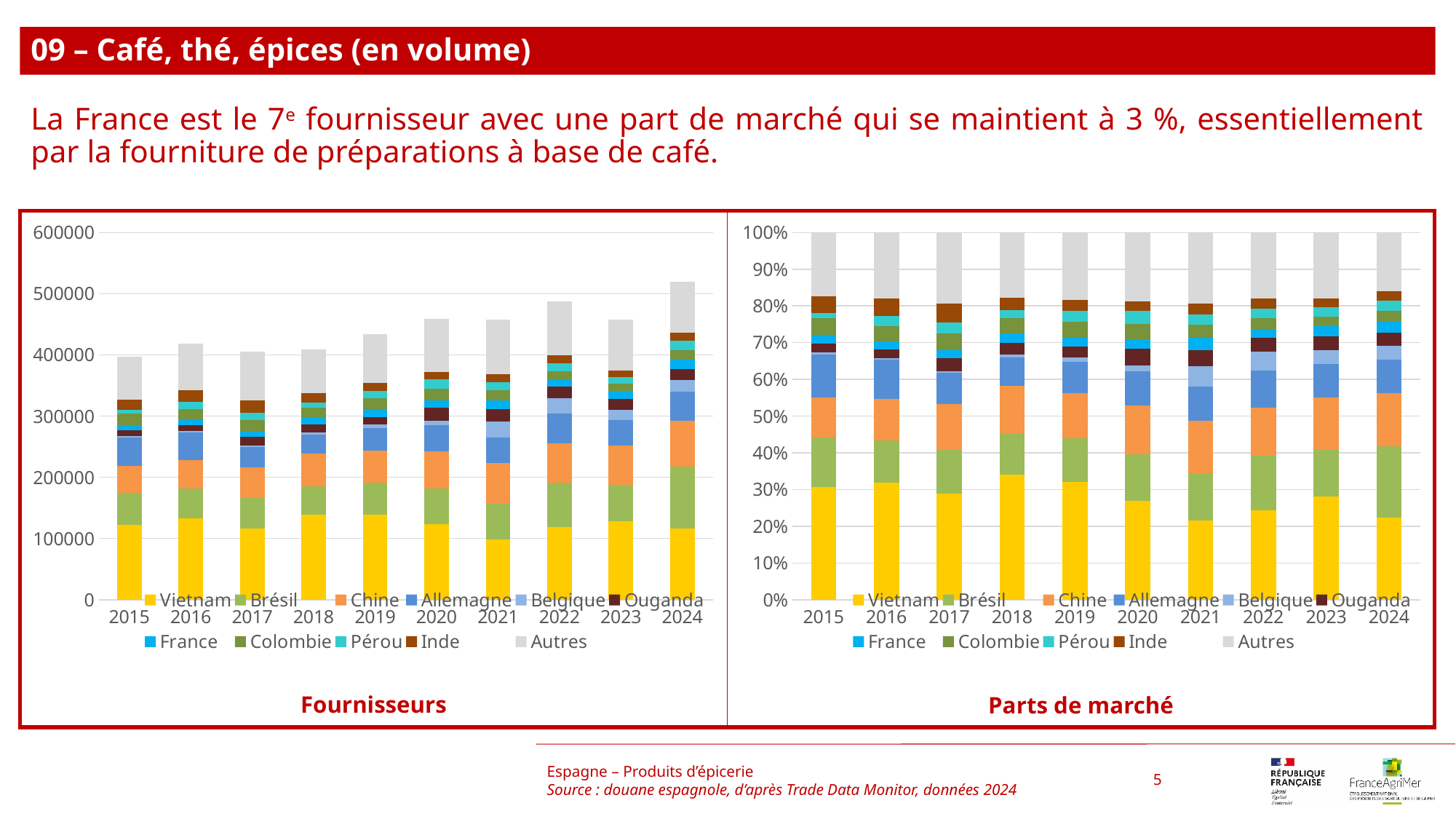
What kind of chart is the 'Fournisseurs' chart on the left? stacked bar chart In the 'Fournisseurs' chart, which total bar is larger, 2015 or 2024? 2024 How many years are shown on the x axis of the 'Parts de marché' chart? 10 In the 'Parts de marché' chart, which is larger in 2024, the Vietnam share or the Brésil share? Vietnam How many series does the legend of the 'Fournisseurs' chart list? 11 In the 'Fournisseurs' chart, do the total bars generally rise or fall from 2015 to 2024? rise In the 'Parts de marché' chart, is the Vietnam share in 2018 greater or less than 30%? greater What colour represents Vietnam in the legend of the charts? yellow In the 'Fournisseurs' chart, which year has the highest total bar? 2024 In the 'Parts de marché' chart, is the Vietnam share in 2024 greater or less than 30%? less In the 'Fournisseurs' chart, is the total for 2024 greater or less than 500000? greater